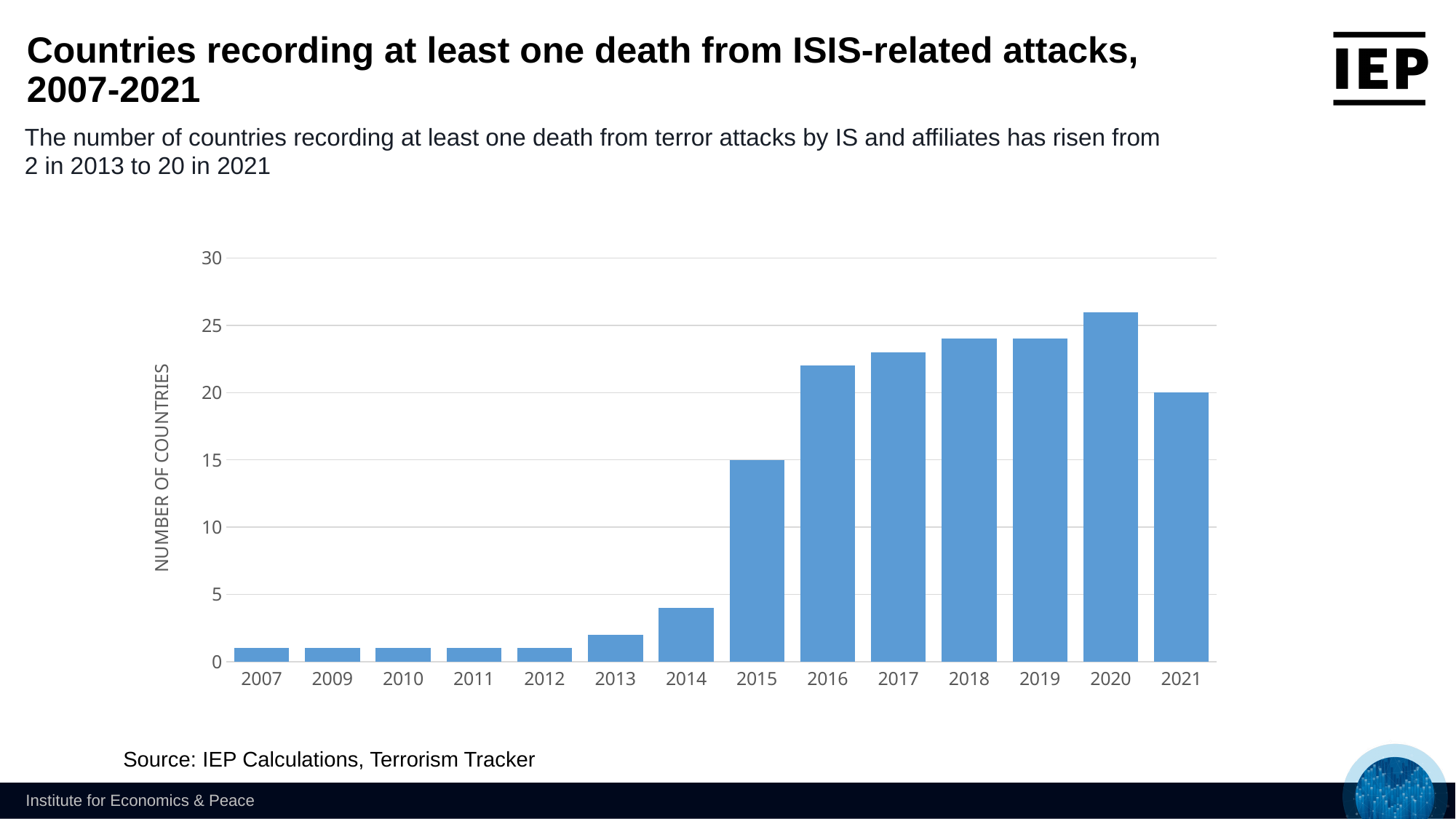
How many years are shown on the x axis of the chart? 14 What kind of chart is shown on the slide? bar chart What is the number of countries for 2021? 20 Is the value for 2020 greater or less than 25? greater Which year has the larger value, 2020 or 2021? 2020 Is the value for 2016 greater or less than 20? greater Which year has the highest number of countries? 2020 What is the difference between the number of countries in 2021 and in 2013? 18 What is the number of countries for 2013? 2 What is the number of countries for 2015? 15 Is the value for 2014 greater or less than 5? less What is the label on the vertical axis of the chart? NUMBER OF COUNTRIES